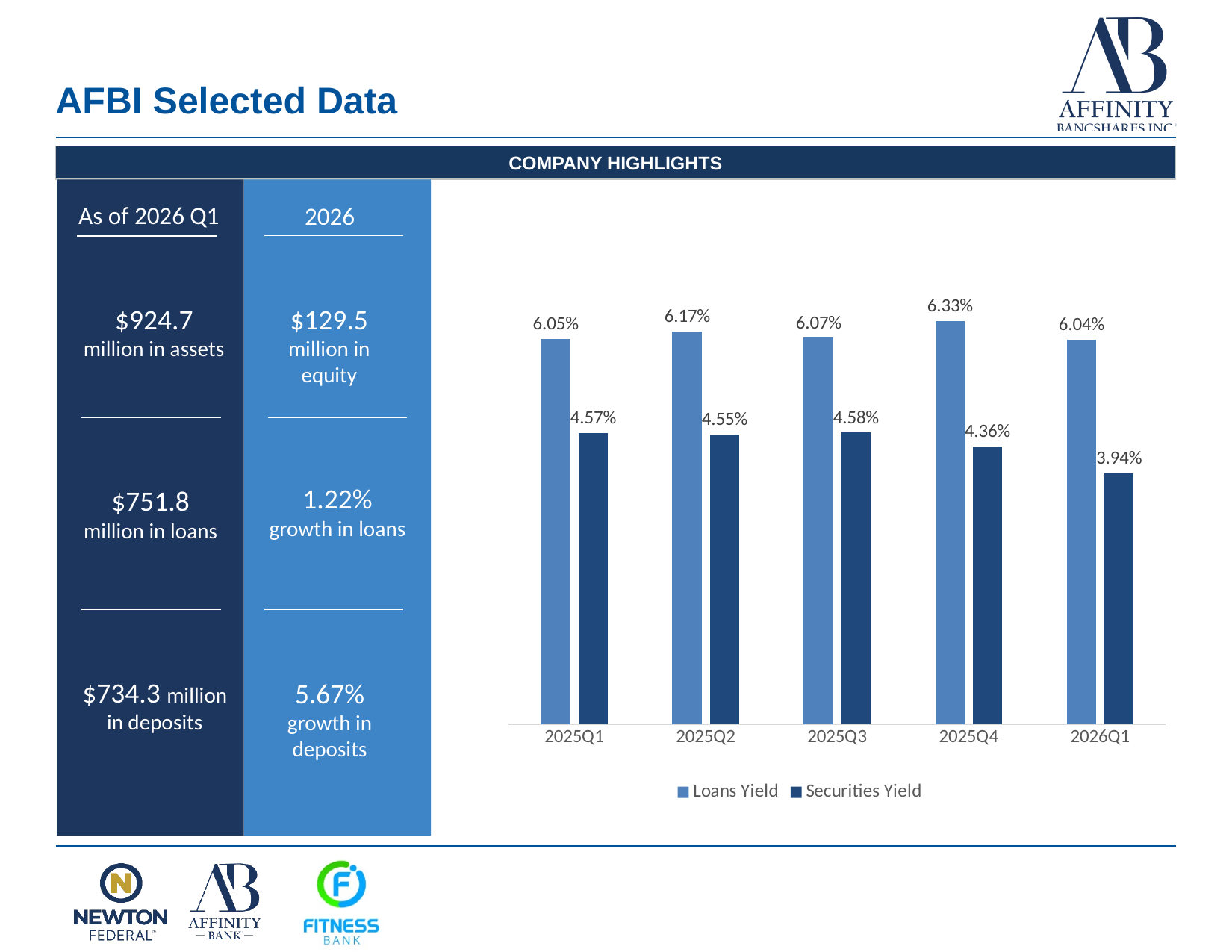
Which quarter has the lowest Securities Yield? 2026Q1 What is the Loans Yield for 2025Q4? 6.33% What is the difference between the Loans Yield and the Securities Yield in 2026Q1? 2.10% How many quarters are shown on the x axis of the chart? 5 What is the difference in Securities Yield between 2025Q4 and 2026Q1? 0.42% What is the Securities Yield for 2025Q1? 4.57% What kind of chart is shown on the slide? Bar chart Which quarter has the highest Loans Yield? 2025Q4 Which is larger, the Loans Yield in 2025Q2 or the Loans Yield in 2025Q3? 2025Q2 What is the Securities Yield for 2026Q1? 3.94% Does the Securities Yield rise or fall from 2025Q3 to 2026Q1? Fall How many series does the chart legend list? 2